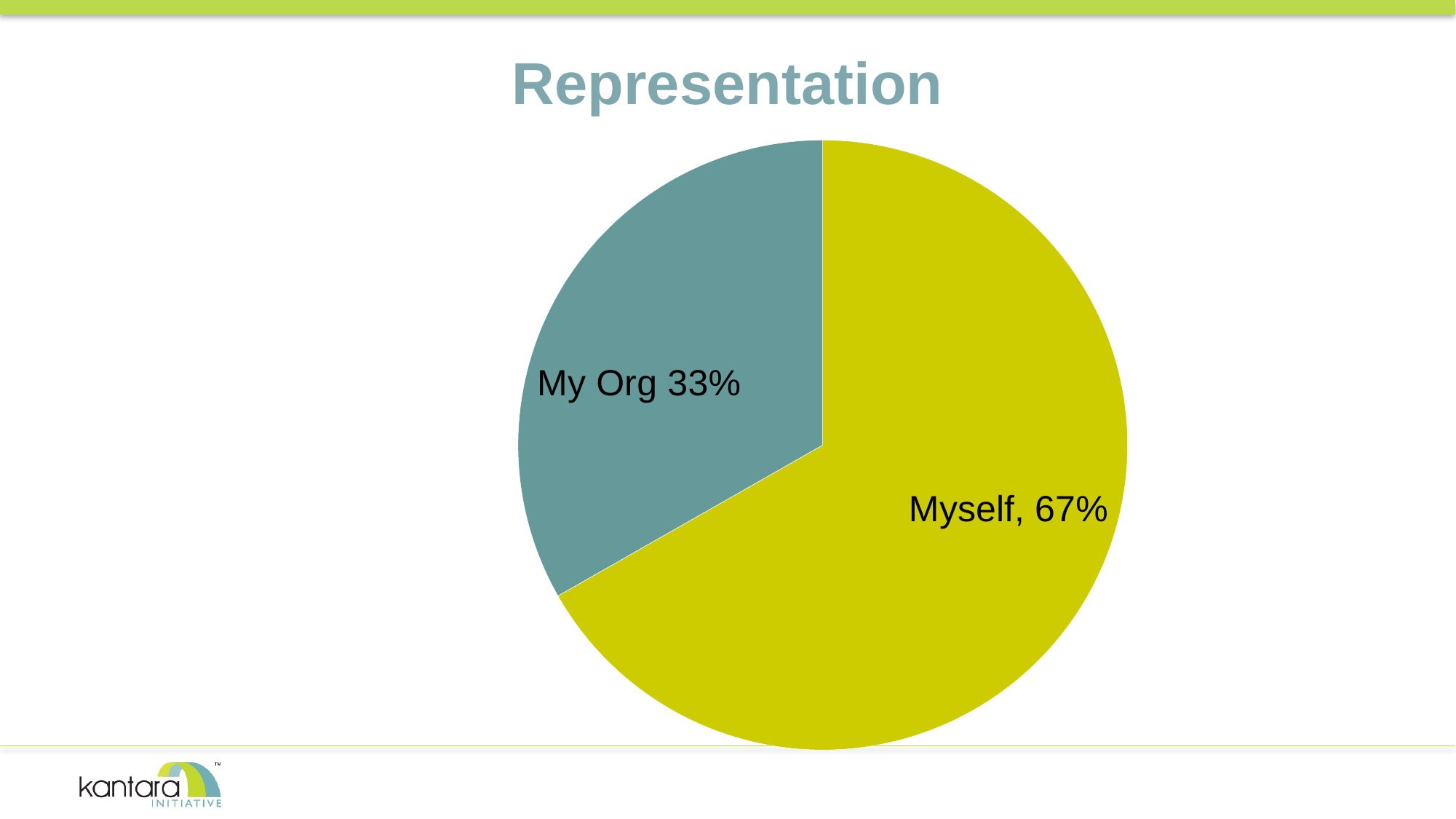
What colour is the Myself slice? yellow-green Which slice is the largest? Myself Is the value for My Org greater or less than 50%? less What share of the pie does the My Org slice represent? 33% What kind of chart is shown on the slide? pie chart What is the title of the chart? Representation Which slice is the smallest? My Org What is the difference in percentage points between the Myself slice and the My Org slice? 34 How many slices does the pie chart have? 2 What share of the pie does the Myself slice represent? 67% Which is larger, the Myself slice or the My Org slice? Myself